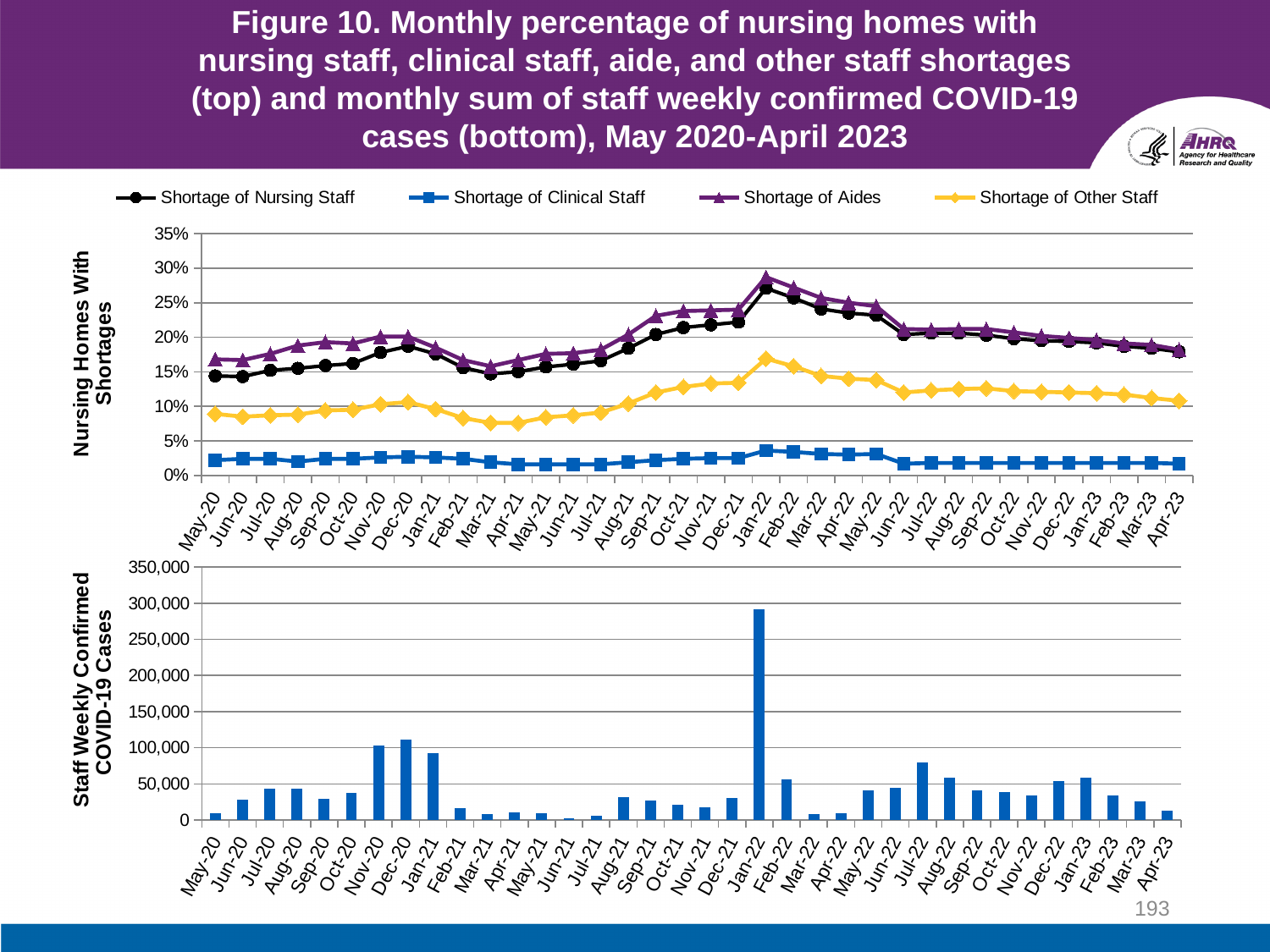
How many months are plotted along the x axis of the bottom chart? 36 In the top chart, is the value for Shortage of Aides in Jan-22 greater or less than 25%? greater What kind of chart is the top chart on the slide? line chart In the bottom chart, is the value for Jan-22 greater or less than 250,000? greater What kind of chart is the bottom chart on the slide? bar chart In the bottom chart, which month has the highest number of staff weekly confirmed COVID-19 cases? Jan-22 In the bottom chart, is the value for Jul-22 greater or less than 100,000? less How many series does the legend of the top chart list? 4 In the top chart, does the Shortage of Nursing Staff series rise or fall from Jan-22 to Apr-23? fall In the top chart, which is larger in Jan-22: Shortage of Aides or Shortage of Other Staff? Shortage of Aides In the top chart, which series has the lowest values across the whole period? Shortage of Clinical Staff